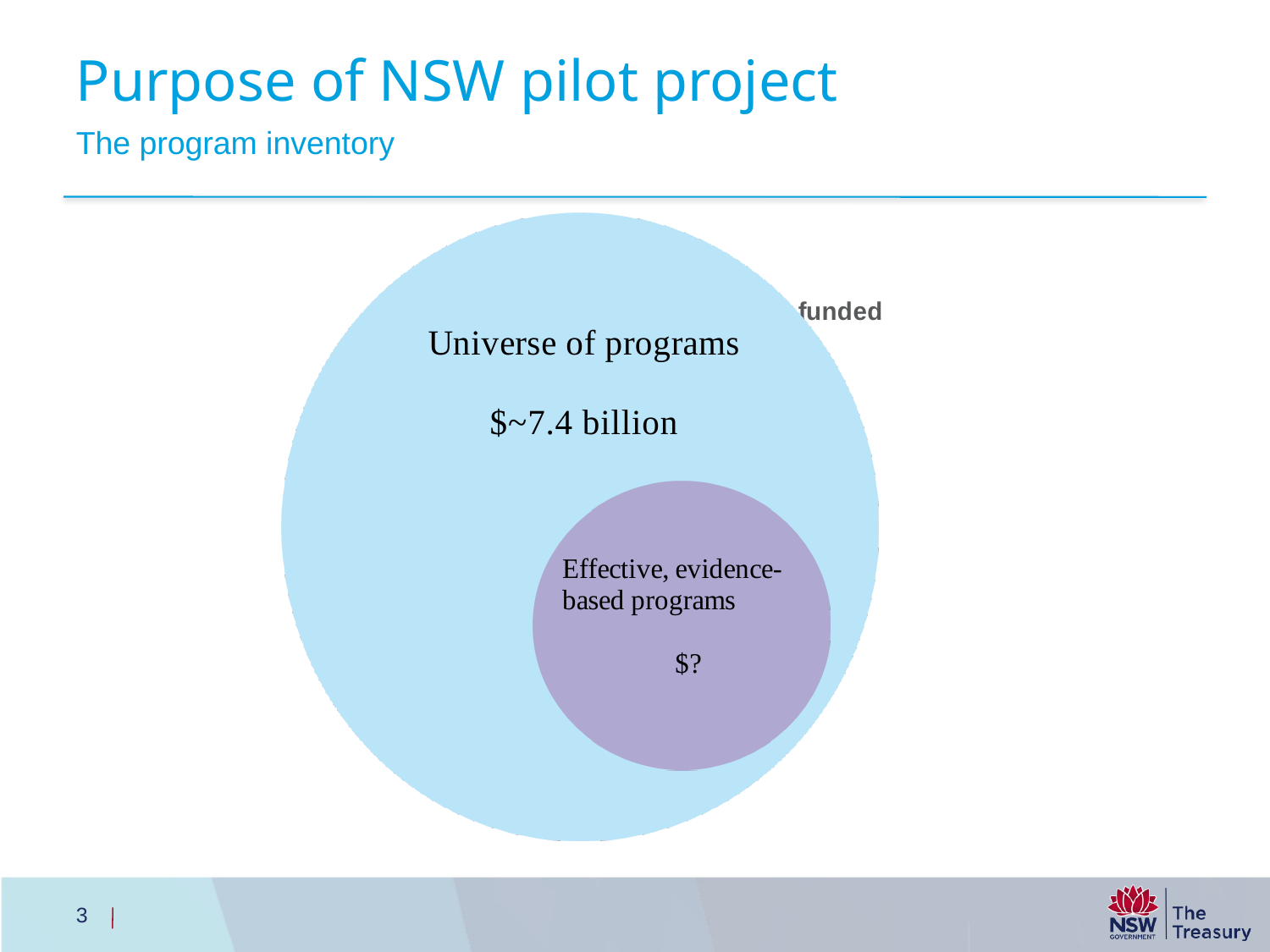
What kind of diagram is shown on the slide? Nested circle (Venn-style) diagram Which circle is drawn inside the other: 'Universe of programs' or 'Effective, evidence-based programs'? Effective, evidence-based programs How many circles does the diagram contain? 2 What dollar amount is printed for the 'Universe of programs' circle? $~7.4 billion What dollar amount is printed for the 'Effective, evidence-based programs' circle? $? What colour is the smaller inner circle? Purple